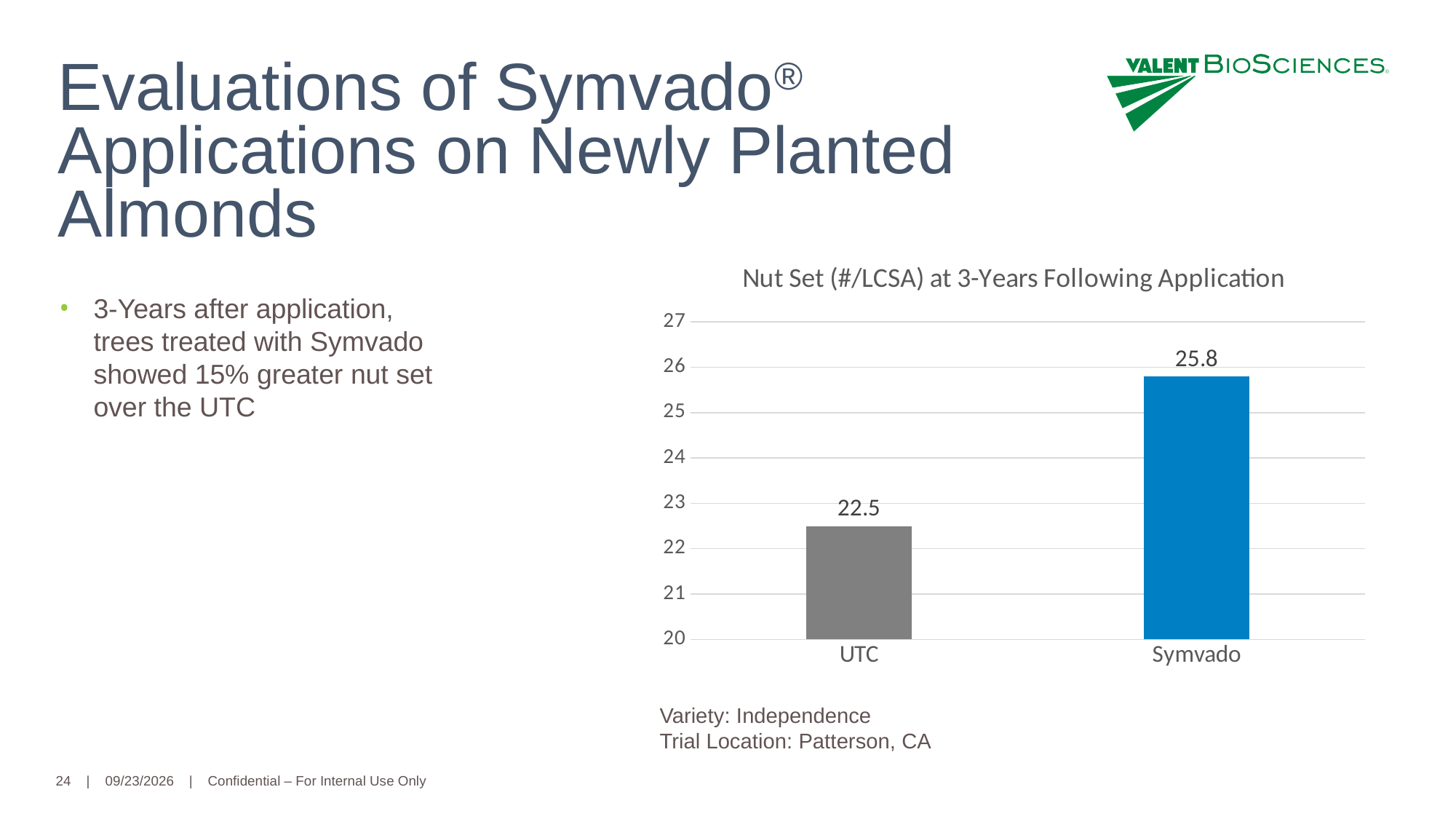
What colour is the Symvado bar? blue How many treatments are shown in the chart? 2 What kind of chart is shown on the slide? bar chart What is the difference in nut set between Symvado and UTC? 3.3 What is the nut set value for Symvado? 25.8 What is the title of the chart? Nut Set (#/LCSA) at 3-Years Following Application Which has a larger nut set, UTC or Symvado? Symvado Is the value for Symvado greater or less than 25? greater Which treatment has the lowest nut set? UTC What is the nut set value for UTC? 22.5 Is the value for UTC greater or less than 23? less Which treatment has the highest nut set? Symvado